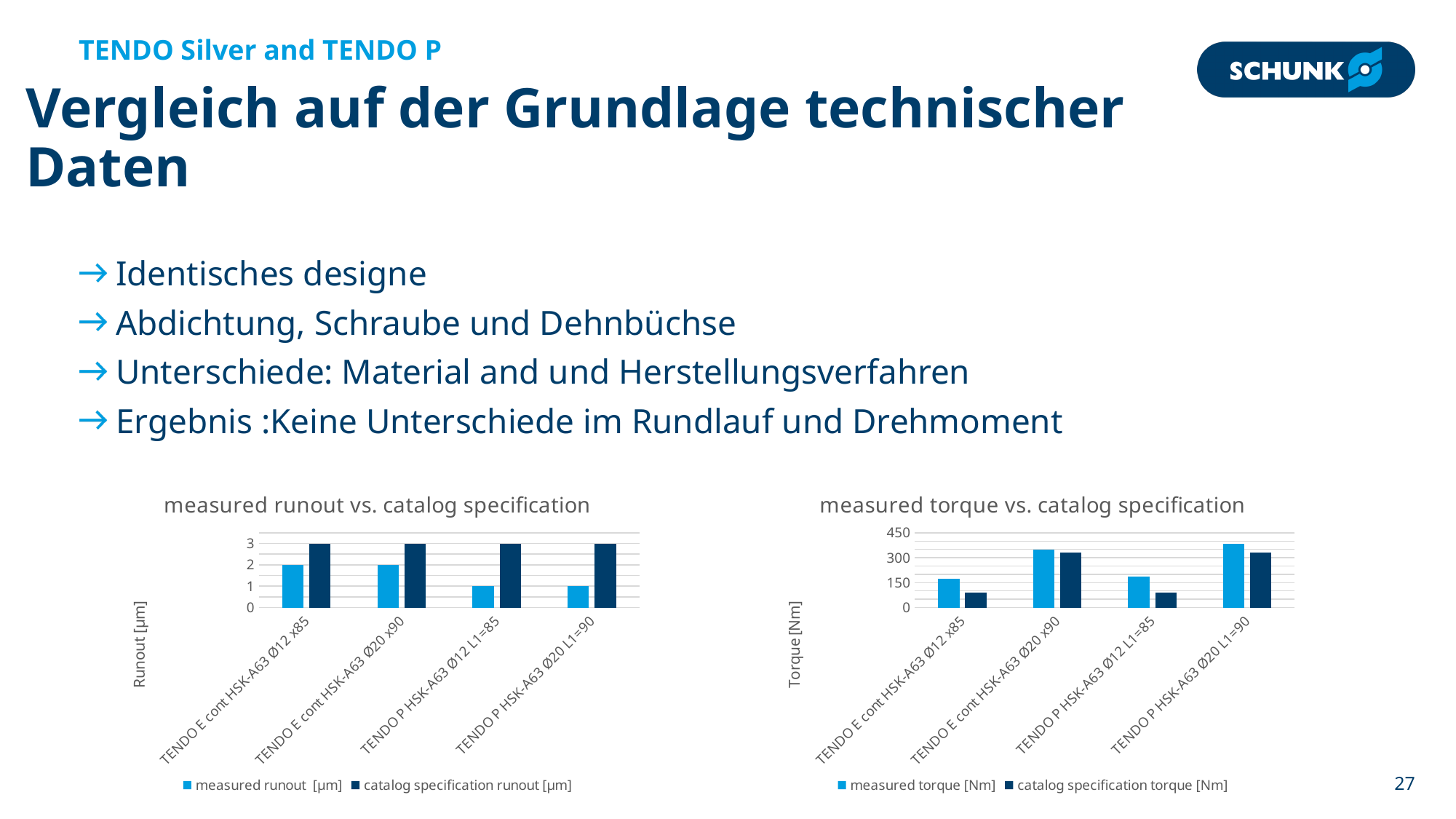
In the 'measured torque vs. catalog specification' chart, is the measured torque for TENDO E cont HSK-A63 Ø20 x90 greater or less than 300? greater In the 'measured torque vs. catalog specification' chart, which category has the highest measured torque? TENDO P HSK-A63 Ø20 L1=90 What is the y-axis label of the 'measured torque vs. catalog specification' chart? Torque [Nm] In the 'measured torque vs. catalog specification' chart, is the catalog specification torque for TENDO P HSK-A63 Ø12 L1=85 greater or less than 150? less In the 'measured runout vs. catalog specification' chart, which is larger for TENDO P HSK-A63 Ø12 L1=85: the measured runout or the catalog specification runout? catalog specification runout In the 'measured runout vs. catalog specification' chart, what is the catalog specification runout for TENDO P HSK-A63 Ø12 L1=85? 3 What kind of chart is the 'measured torque vs. catalog specification' chart? bar chart How many series does the legend of the 'measured torque vs. catalog specification' chart list? 2 In the 'measured runout vs. catalog specification' chart, what is the measured runout for TENDO E cont HSK-A63 Ø12 x85? 2 In the 'measured runout vs. catalog specification' chart, what is the measured runout for TENDO P HSK-A63 Ø20 L1=90? 1 In the 'measured runout vs. catalog specification' chart, what is the difference between the catalog specification runout and the measured runout for TENDO E cont HSK-A63 Ø20 x90? 1 How many categories are shown on the x axis of the 'measured runout vs. catalog specification' chart? 4